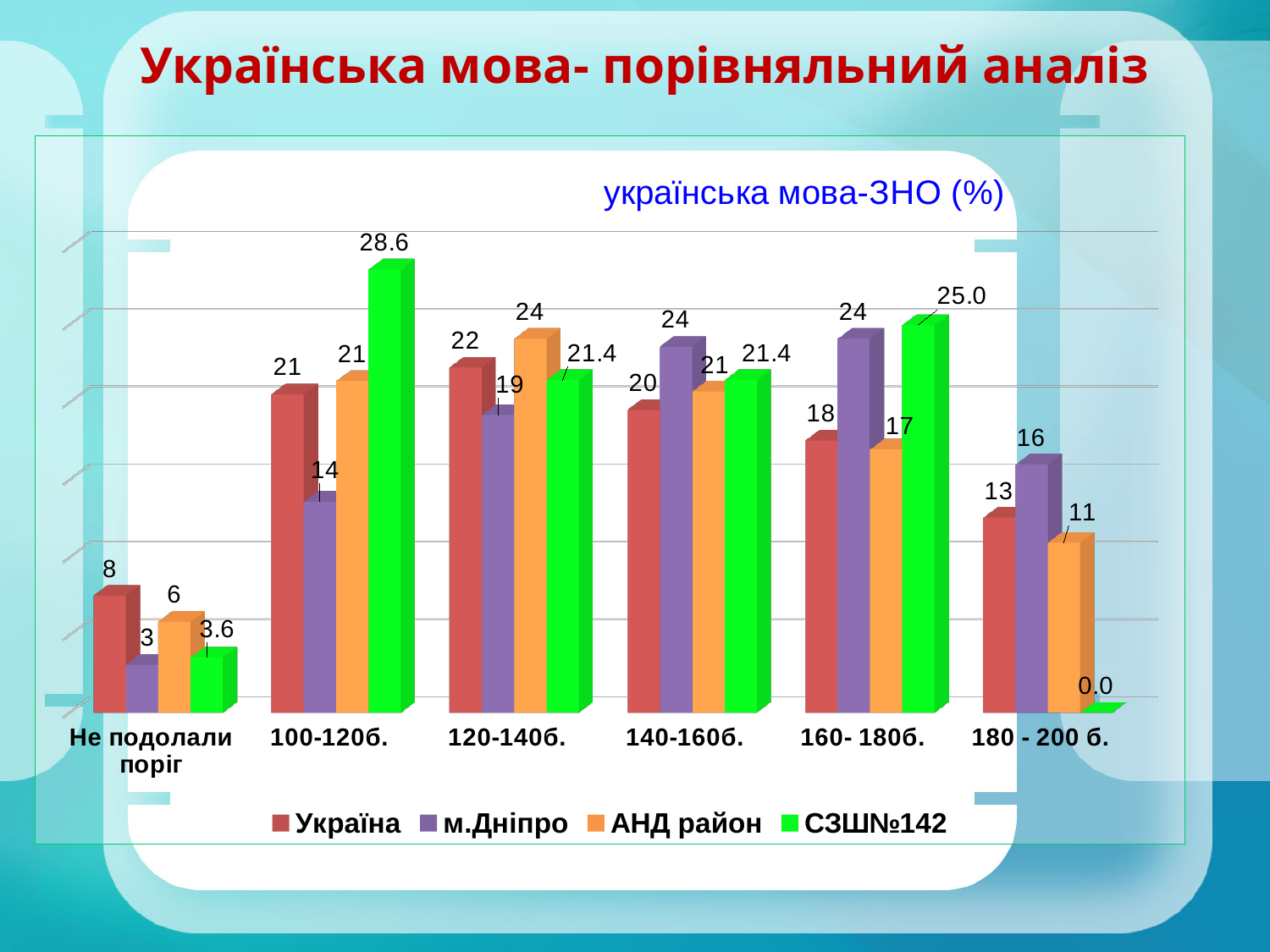
In which category does the Україна series reach its highest value? 120-140б. In which category does the СЗШ№142 series have its lowest value? 180 - 200 б. What is the value for АНД район in the 120-140б. category? 24 In the 160- 180б. category, which is larger: м.Дніпро or АНД район? м.Дніпро What kind of chart is shown on the slide? bar chart What is the title of the chart? українська мова-ЗНО (%) What is the difference between the СЗШ№142 value and the Україна value in the 100-120б. category? 7.6 What is the value for СЗШ№142 in the 180 - 200 б. category? 0.0 What is the value for СЗШ№142 in the 100-120б. category? 28.6 How many series does the legend list? 4 What is the value for м.Дніпро in the 'Не подолали поріг' category? 3 How many categories are shown on the x axis? 6